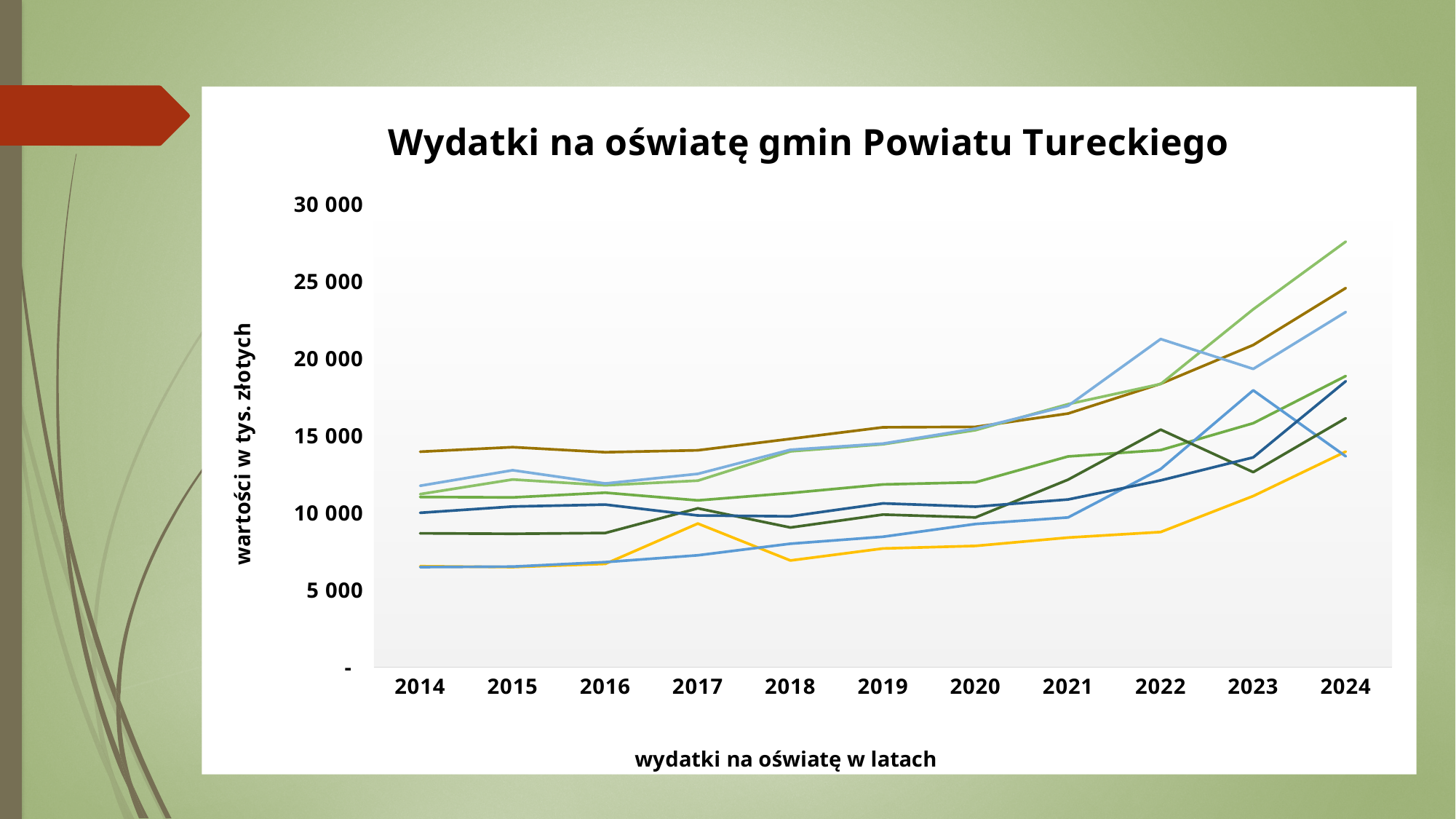
What is the label of the vertical axis? wartości w tys. złotych Is the value of the highest line in 2024 greater or less than 25 000? greater In which year does the light green line reach its highest value? 2024 In 2024, which line is higher: the light green line or the brown line? the light green line Is the value of the yellow line in 2014 greater or less than 10 000? less What kind of chart is shown on the slide? line chart Is the value of the light blue line in 2022 greater or less than 20 000? greater What is the first year shown on the x axis? 2014 What is the title of the chart? Wydatki na oświatę gmin Powiatu Tureckiego What is the last year shown on the x axis? 2024 Do the values of the light green line generally rise or fall from 2014 to 2024? rise How many years are shown on the x axis? 11